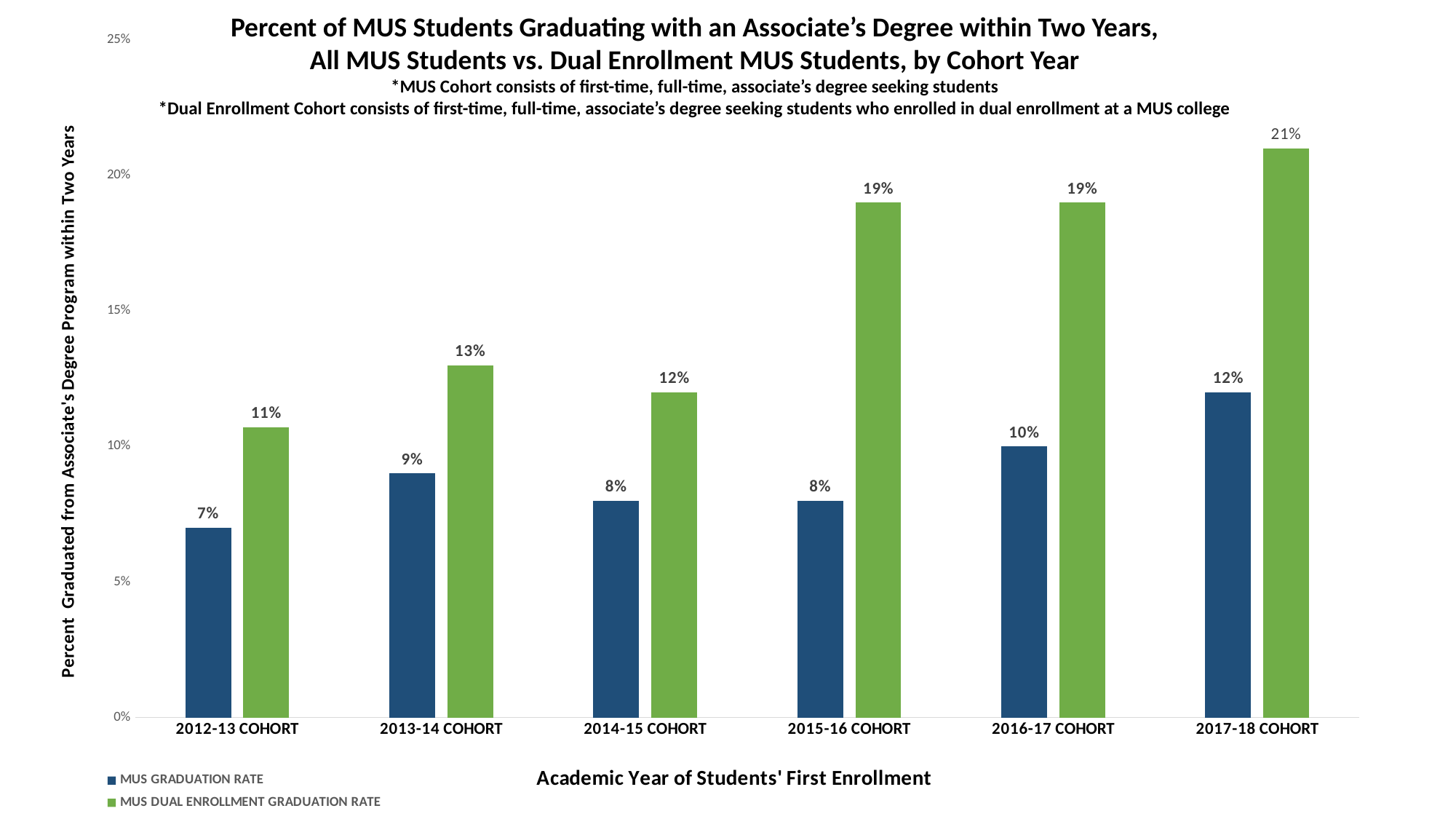
What kind of chart is shown on the slide? Bar chart Which cohort has the highest MUS Graduation Rate? 2017-18 Cohort What colour are the bars for the MUS Dual Enrollment Graduation Rate? Green Which is larger for the 2013-14 Cohort: the MUS Graduation Rate or the MUS Dual Enrollment Graduation Rate? MUS Dual Enrollment Graduation Rate Which cohort has the lowest MUS Dual Enrollment Graduation Rate? 2012-13 Cohort What is the MUS Dual Enrollment Graduation Rate for the 2017-18 Cohort? 21% What is the MUS Dual Enrollment Graduation Rate for the 2014-15 Cohort? 12% Is the MUS Dual Enrollment Graduation Rate for the 2016-17 Cohort greater or less than 15%? greater How many cohort years are shown on the x axis? 6 What is the MUS Graduation Rate for the 2012-13 Cohort? 7% How many series does the legend list? 2 What is the difference between the MUS Dual Enrollment Graduation Rate and the MUS Graduation Rate for the 2015-16 Cohort? 11%